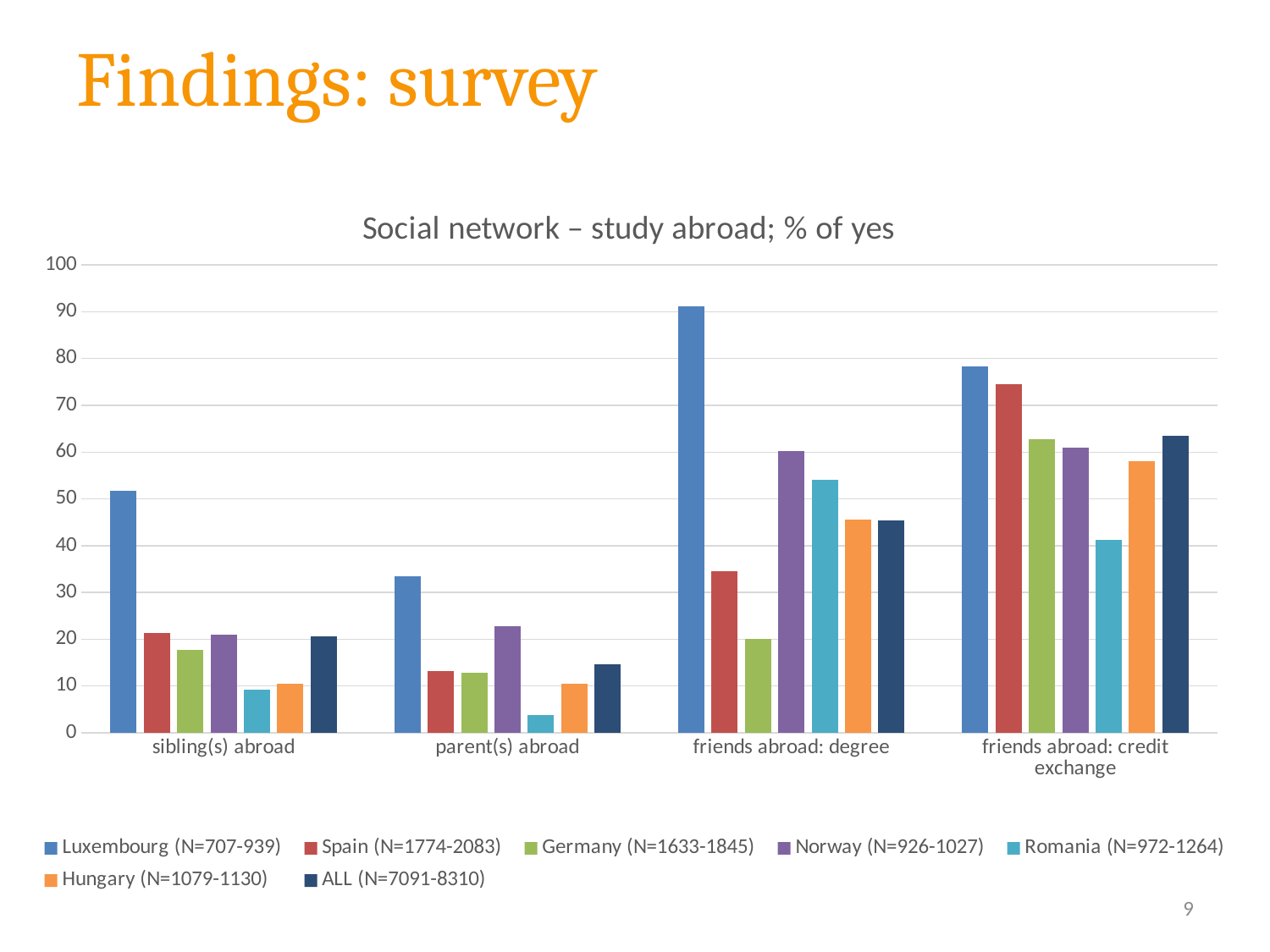
Which series has the highest value for 'friends abroad: credit exchange'? Luxembourg (N=707-939) What kind of chart is shown on the slide? bar chart What is the title of the chart? Social network – study abroad; % of yes Which series has the highest value for 'friends abroad: degree'? Luxembourg (N=707-939) Which series has the lowest value for 'parent(s) abroad'? Romania (N=972-1264) For 'friends abroad: credit exchange', which is larger: Spain or Germany? Spain Is the value for Romania in 'parent(s) abroad' greater or less than 10? less For 'friends abroad: degree', which is larger: Norway or Spain? Norway Is the value for Luxembourg in 'sibling(s) abroad' greater or less than 50? greater Is the value for Luxembourg in 'friends abroad: degree' greater or less than 80? greater How many series does the legend list? 7 How many categories are shown on the x axis? 4